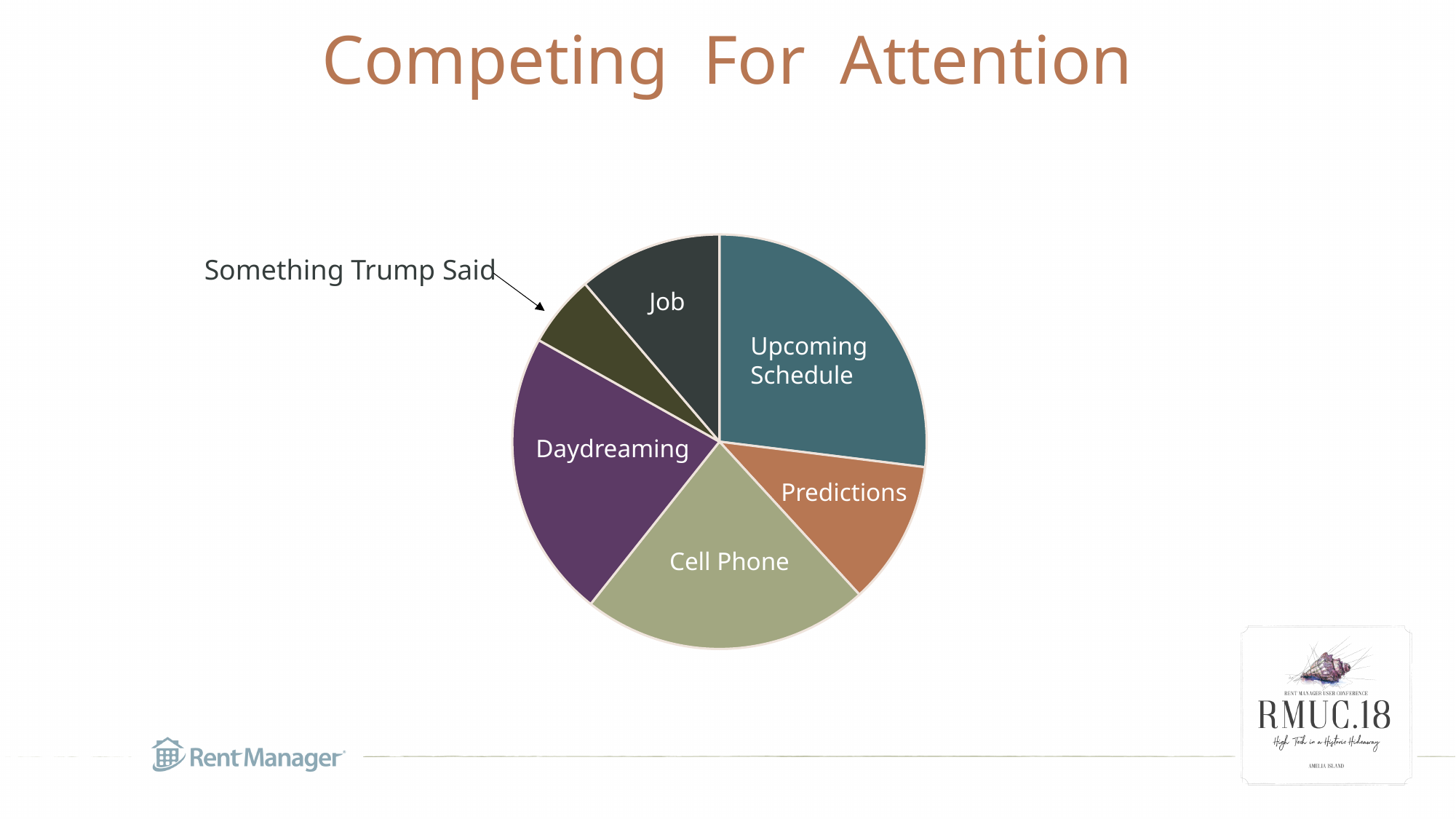
What kind of chart is shown on the slide? Pie chart How many slices does the pie chart have? 6 Which slice of the pie chart is the smallest? Something Trump Said Which slice is larger, Job or Something Trump Said? Job Which slice of the pie chart is the largest? Upcoming Schedule Which slice is larger, Cell Phone or Job? Cell Phone What is the title of the slide containing the pie chart? Competing For Attention Which slice is larger, Daydreaming or Predictions? Daydreaming Which slice is labelled with an arrow pointing to it from outside the pie? Something Trump Said